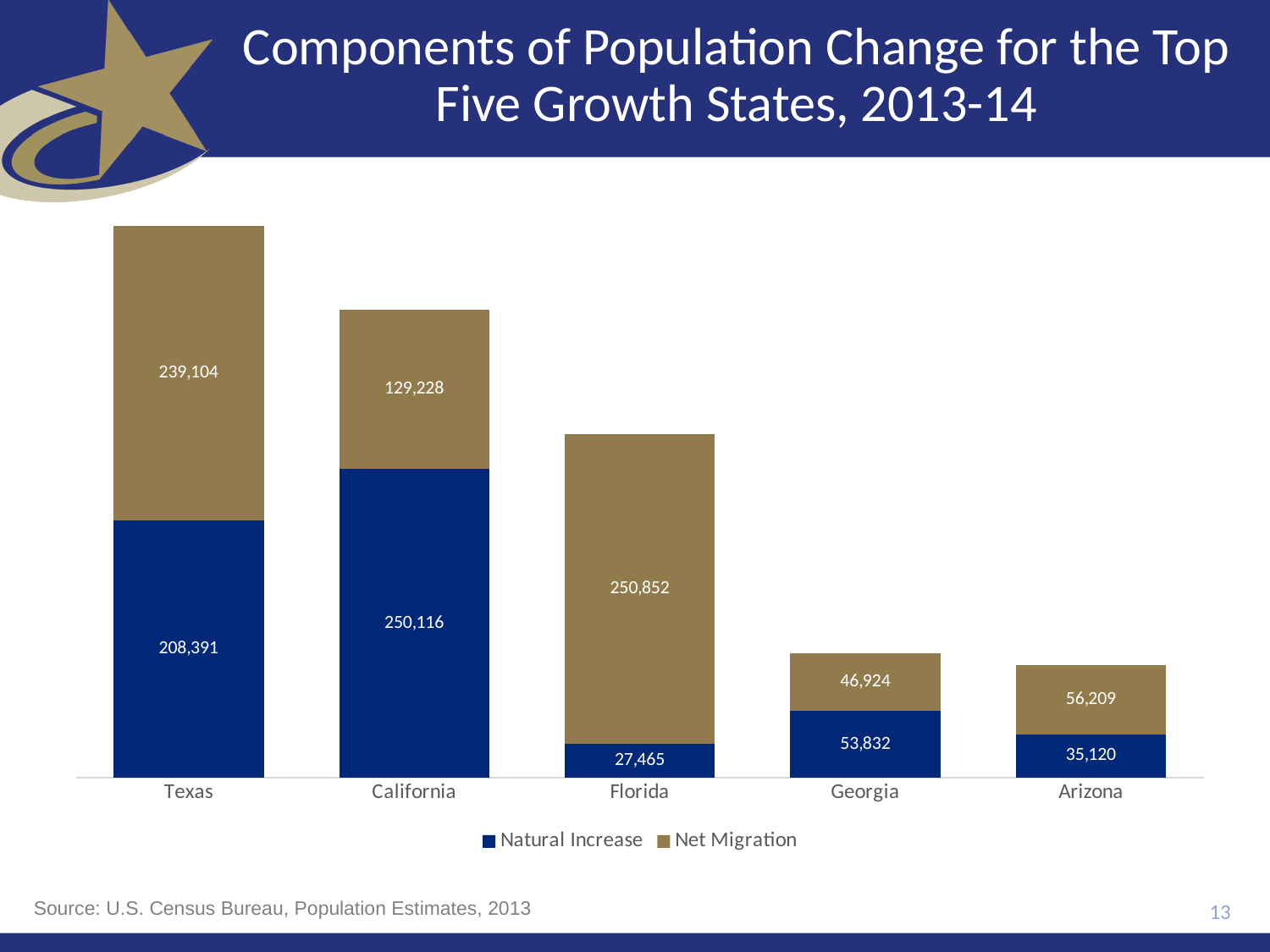
What is the Natural Increase value for Texas? 208,391 What is the Net Migration value for Arizona? 56,209 Is Net Migration for Florida larger than Net Migration for California? Yes How many states are shown on the chart? 5 What is the total population change (Natural Increase plus Net Migration) for Texas? 447,495 Which state has the lowest Natural Increase? Florida What is the total population change (Natural Increase plus Net Migration) for Georgia? 100,756 How many series does the legend list? 2 Which state has the lowest Net Migration? Georgia What is the Net Migration value for Florida? 250,852 What is the difference between Net Migration and Natural Increase for Texas? 30,713 Which state has the highest Natural Increase? California